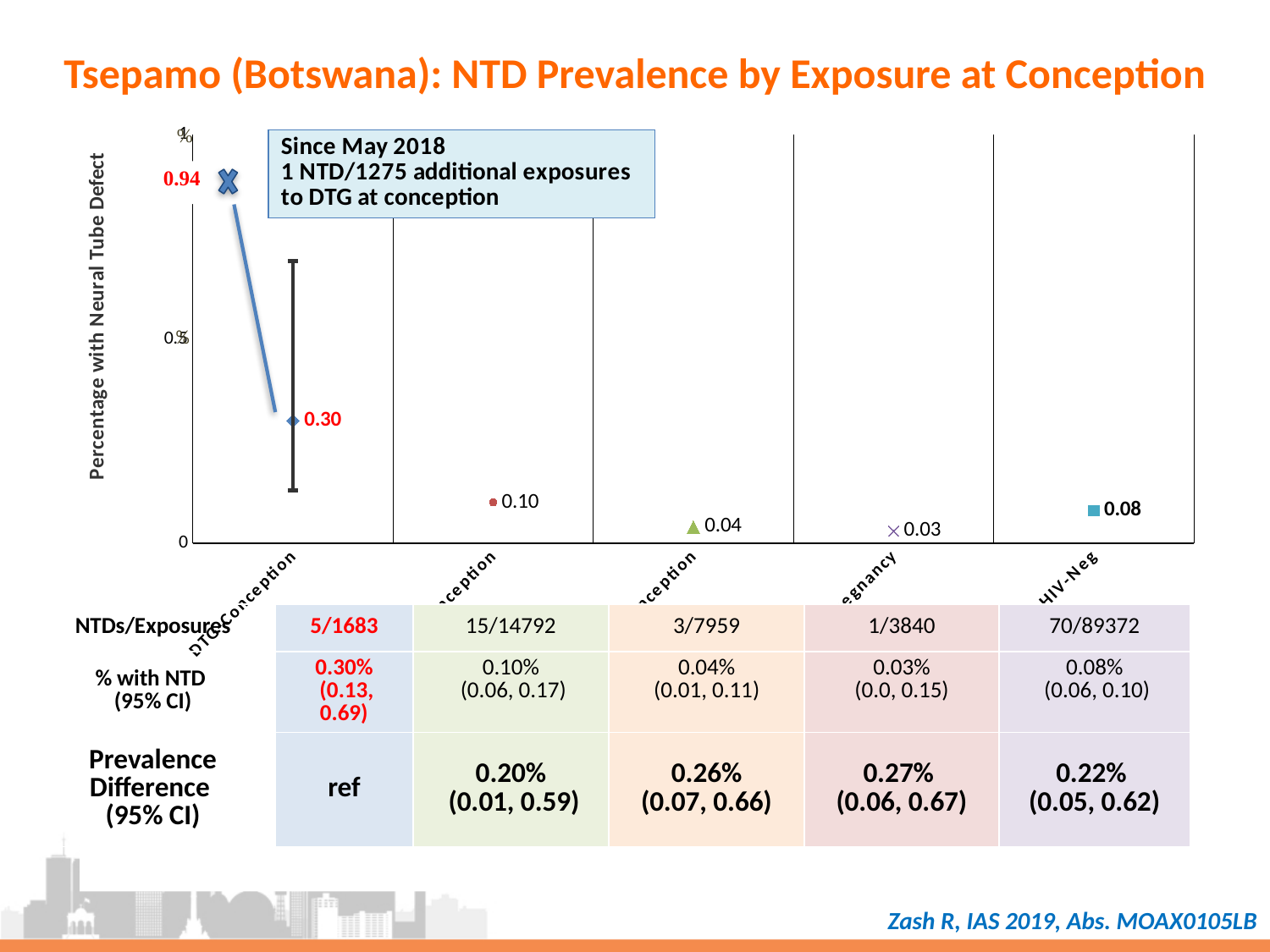
What is the title of the slide's chart? Tsepamo (Botswana): NTD Prevalence by Exposure at Conception Which is larger: the plotted value for HIV-Neg or the plotted value for the second category from the left? the second category from the left What value is shown next to the X marker at the top left of the chart? 0.94 What kind of chart is shown on the slide? scatter chart What is the difference between the plotted values of the second category from the left (0.10) and the third category from the left (0.04)? 0.06 Is the plotted value for DTG Conception greater or less than 0.5? less What is the difference between the plotted value for DTG Conception (0.30) and the plotted value for HIV-Neg (0.08)? 0.22 What is the plotted value for DTG Conception? 0.30 What is the label on the y axis of the chart? Percentage with Neural Tube Defect How many categories are shown along the x axis of the chart? 5 What is the lowest data label value plotted on the chart? 0.03 What is the plotted value for HIV-Neg? 0.08